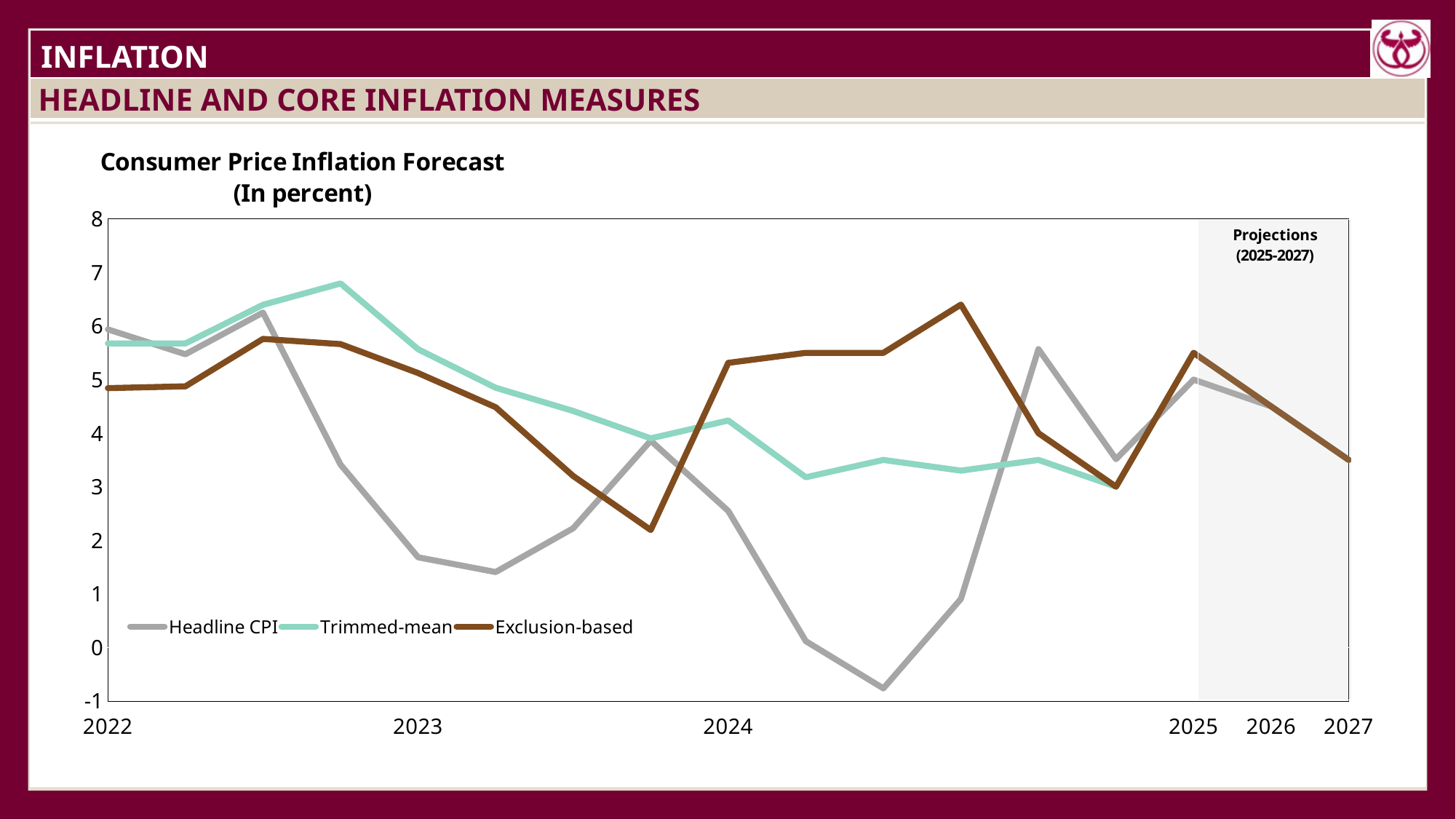
Does the Exclusion-based line rise or fall from 2025 to 2027? fall Is the lowest value of the Headline CPI line greater or less than 0? less Which series reaches the lowest value on the chart? Headline CPI What kind of chart is shown on the slide? line chart At 2024, which is higher: Headline CPI or Exclusion-based? Exclusion-based How many series does the legend list? 3 What are the three series named in the legend? Headline CPI, Trimmed-mean, Exclusion-based Is the peak value of the Trimmed-mean line greater or less than 6? greater Does the Headline CPI line rise or fall from 2022 to 2023? fall Is the Headline CPI value at 2024 greater or less than 3? less What is the title of the chart? Consumer Price Inflation Forecast (In percent)